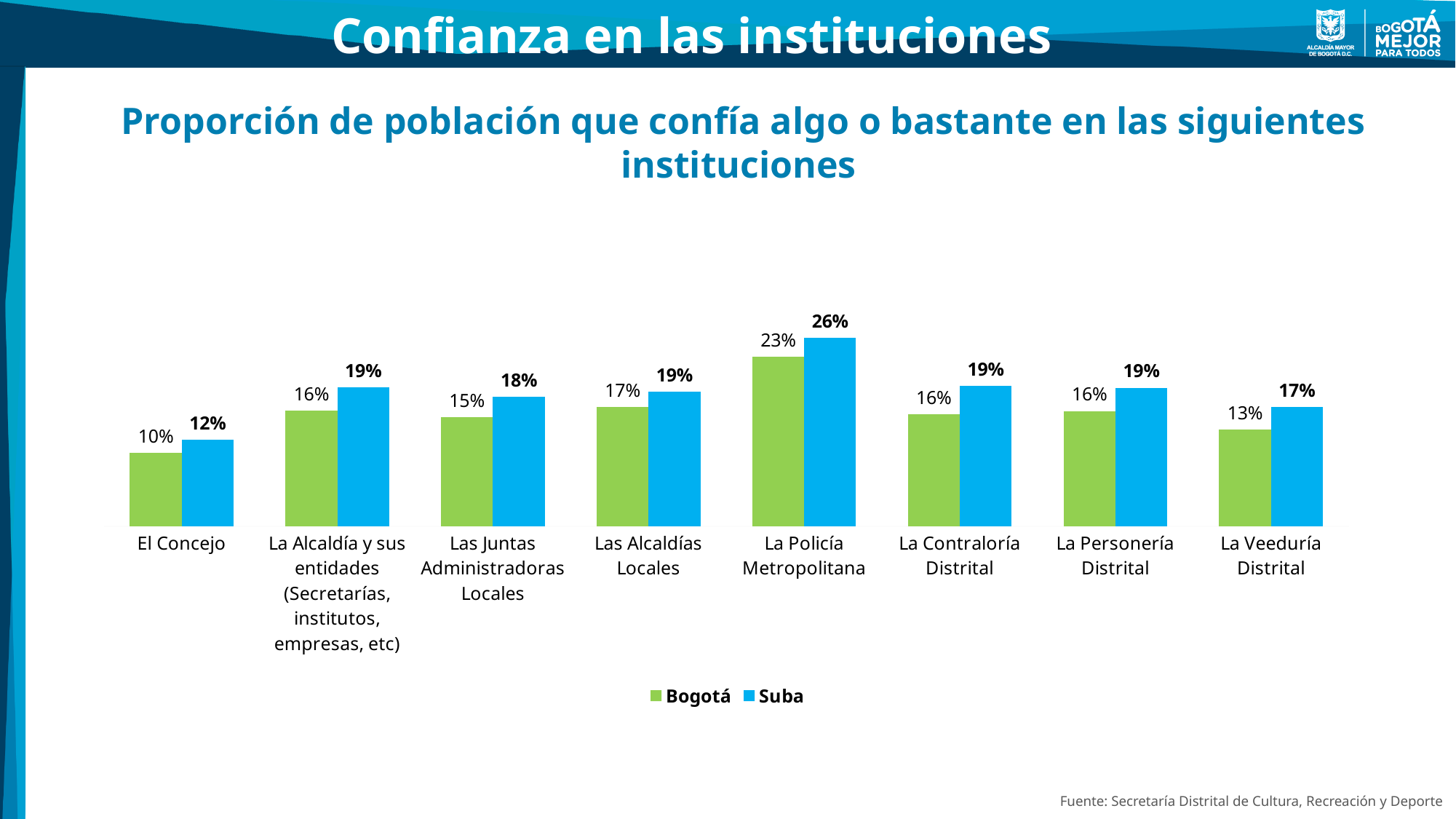
What is the Bogotá value for El Concejo? 10% What is the difference between the Suba value for La Policía Metropolitana and the Suba value for El Concejo? 14% How many institutions are shown on the x axis? 8 Which institution has the lowest Suba value? El Concejo What is the difference between the Suba and Bogotá values for La Veeduría Distrital? 4% What kind of chart is shown on the slide? Bar chart Which is larger for Las Alcaldías Locales, the Bogotá value or the Suba value? Suba How many series does the legend list? 2 What is the Suba value for La Policía Metropolitana? 26% What is the Bogotá value for La Veeduría Distrital? 13% Which institution has the highest Bogotá value? La Policía Metropolitana What is the Suba value for Las Juntas Administradoras Locales? 18%